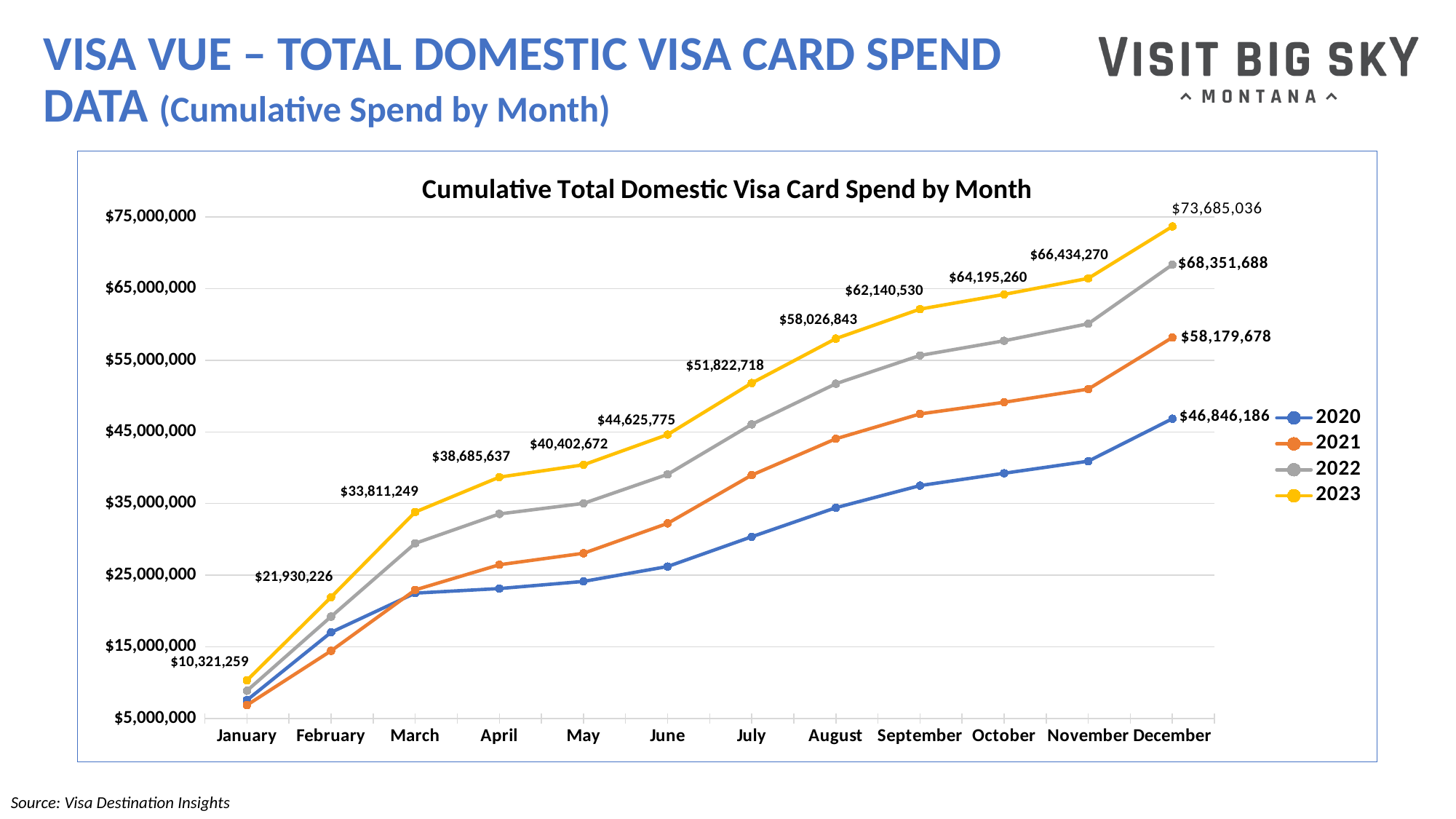
What is the difference between the December cumulative spend for 2023 and 2022? $5,333,348 What is the cumulative spend for 2022 in December? $68,351,688 By how much did the 2023 cumulative spend increase from January to February? $11,608,967 Is the value for 2020 in July greater or less than $35,000,000? less What is the cumulative spend for 2020 in December? $46,846,186 How many series does the legend list? 4 Which year has the lowest cumulative spend in December? 2020 What is the cumulative spend for 2021 in December? $58,179,678 What is the cumulative spend for 2023 in December? $73,685,036 What is the cumulative spend for 2023 in January? $10,321,259 Which year has the highest cumulative spend in December? 2023 How many months are shown on the x axis? 12